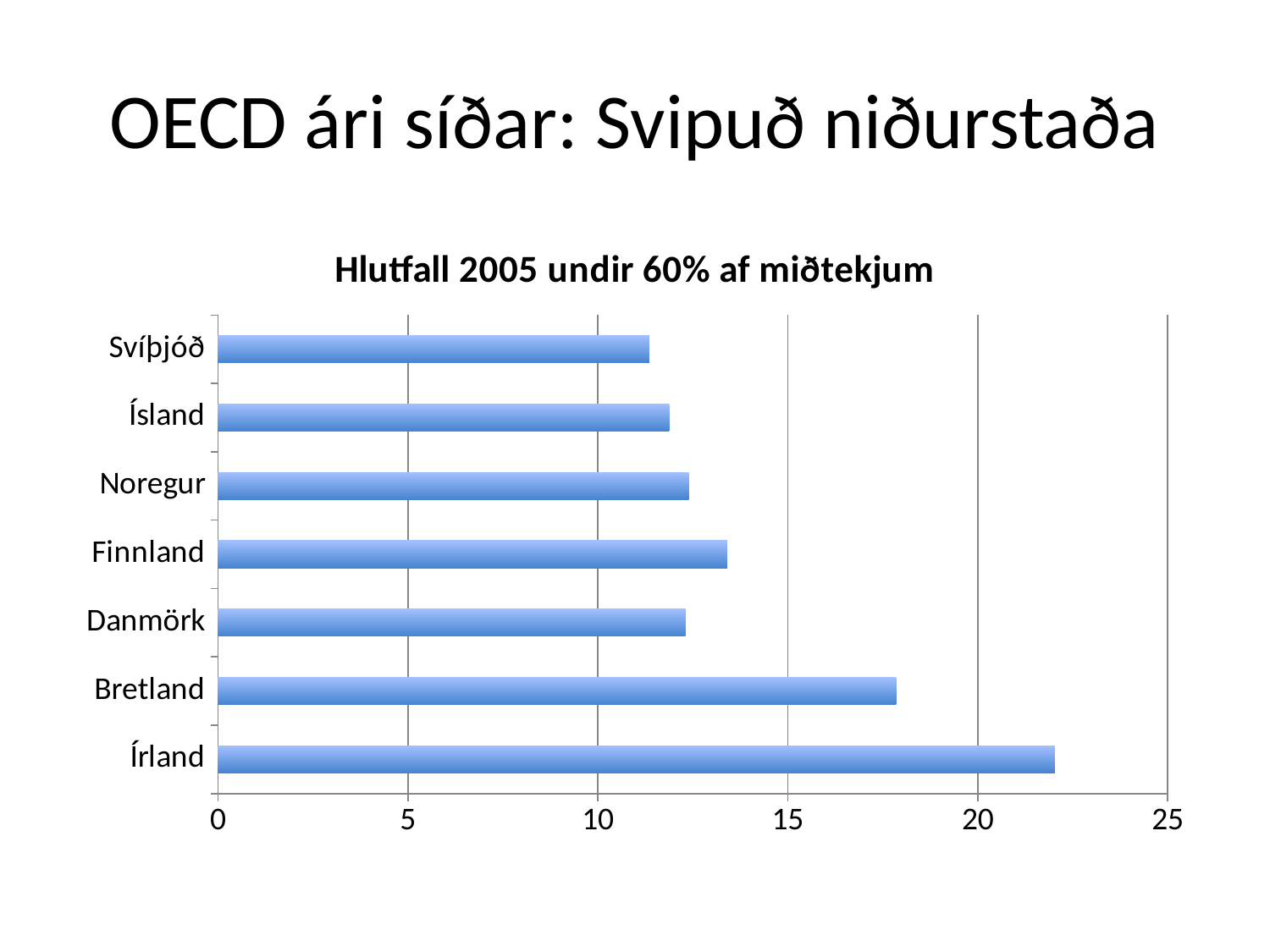
What kind of chart is shown on the slide? bar chart Which country has the lowest value in the chart? Svíþjóð Is the value for Bretland greater or less than 15? greater Is the value for Svíþjóð greater or less than 10? greater Which country has the highest value in the chart? Írland Which has the larger value, Finnland or Ísland? Finnland What is the title of the chart? Hlutfall 2005 undir 60% af miðtekjum Is the value for Írland greater or less than 20? greater How many countries are shown in the chart? 7 Which has the larger value, Írland or Bretland? Írland Which has the larger value, Bretland or Finnland? Bretland